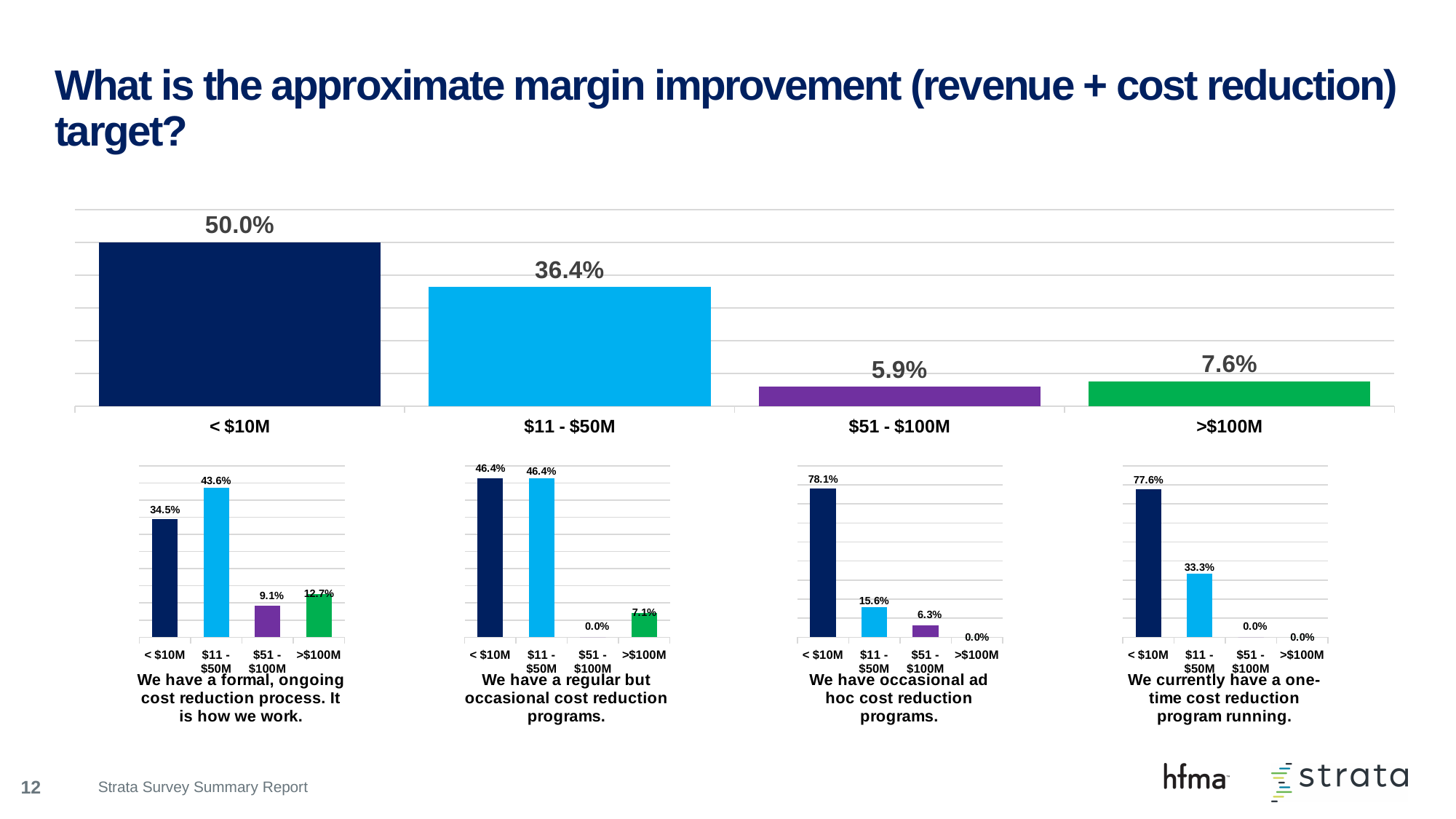
In the large top chart, what is the value for $51 - $100M? 5.9% In the large top chart, what is the difference between the values for < $10M and $11 - $50M? 13.6% What kind of chart is the large top chart? Bar chart In the small chart titled 'We have a formal, ongoing cost reduction process. It is how we work.', what is the value for $11 - $50M? 43.6% How many categories does the large top chart show? 4 In the small chart titled 'We currently have a one-time cost reduction program running.', what is the difference between the values for < $10M and $11 - $50M? 44.3% In the large top chart, what is the value for < $10M? 50.0% In the small chart titled 'We have occasional ad hoc cost reduction programs.', what is the value for < $10M? 78.1% In the large top chart, which is larger: the value for >$100M or the value for $51 - $100M? >$100M In the large top chart, which category has the lowest value? $51 - $100M In the small chart titled 'We have a regular but occasional cost reduction programs.', what is the value for >$100M? 7.1% In the large top chart, which category has the highest value? < $10M